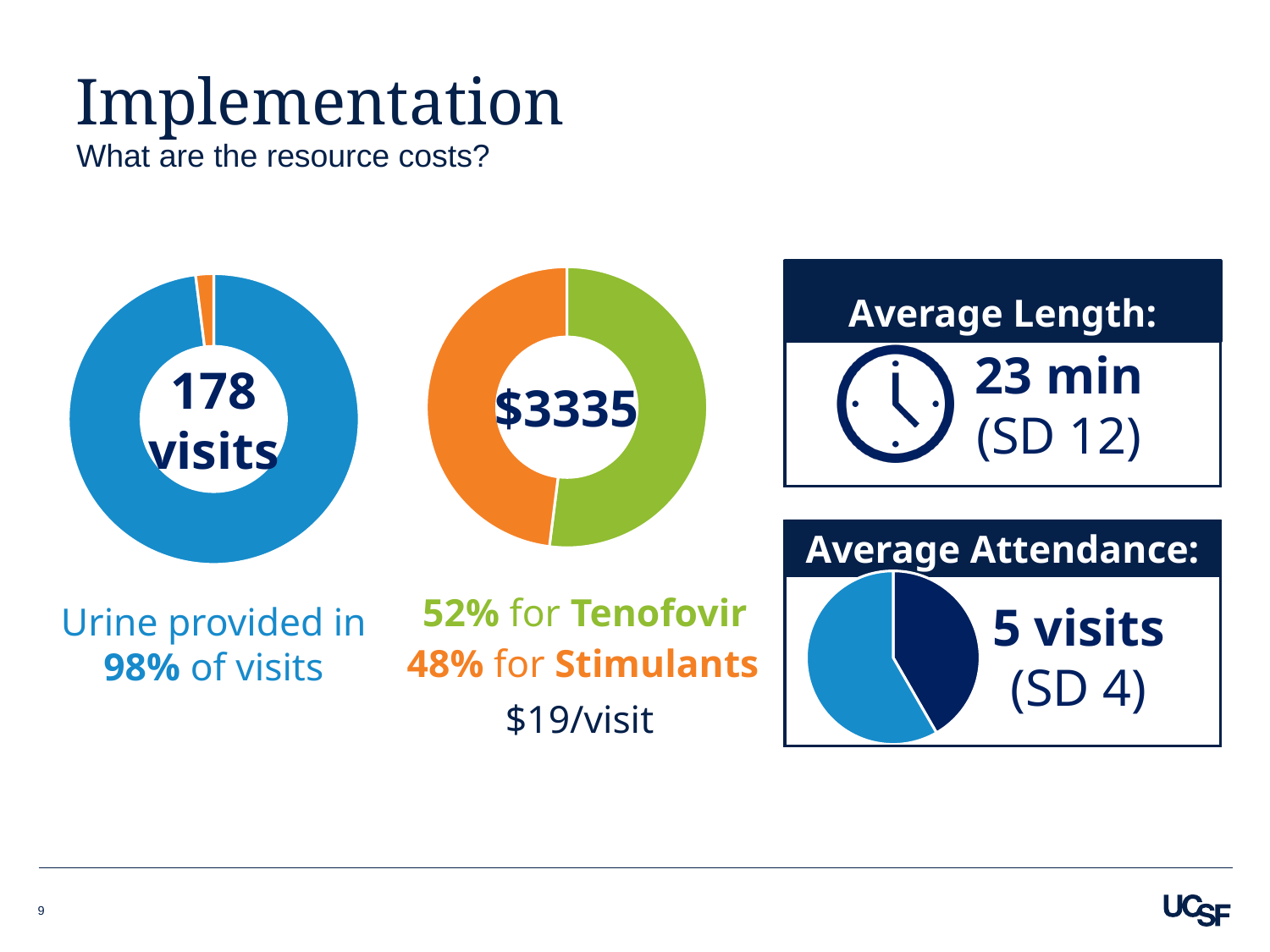
On the middle donut chart, what percentage of the cost is for Tenofovir? 52% On the middle donut chart, what colour represents Tenofovir? Green On the left donut chart, what is the total number of visits shown in the center? 178 visits On the left donut chart, in what percentage of visits was urine provided? 98% On the middle donut chart, how many categories are shown? 2 On the middle donut chart, which category accounts for a larger share of the cost, Tenofovir or Stimulants? Tenofovir On the middle donut chart, what percentage of the cost is for Stimulants? 48% On the middle donut chart, what is the difference in percentage points between the Tenofovir share and the Stimulants share? 4 percentage points What kind of chart is shown inside the Average Attendance box? Pie chart What is the cost per visit stated below the middle donut chart? $19/visit What kind of chart is the left chart showing 178 visits? Donut chart On the middle donut chart, what total cost is shown in the center? $3335